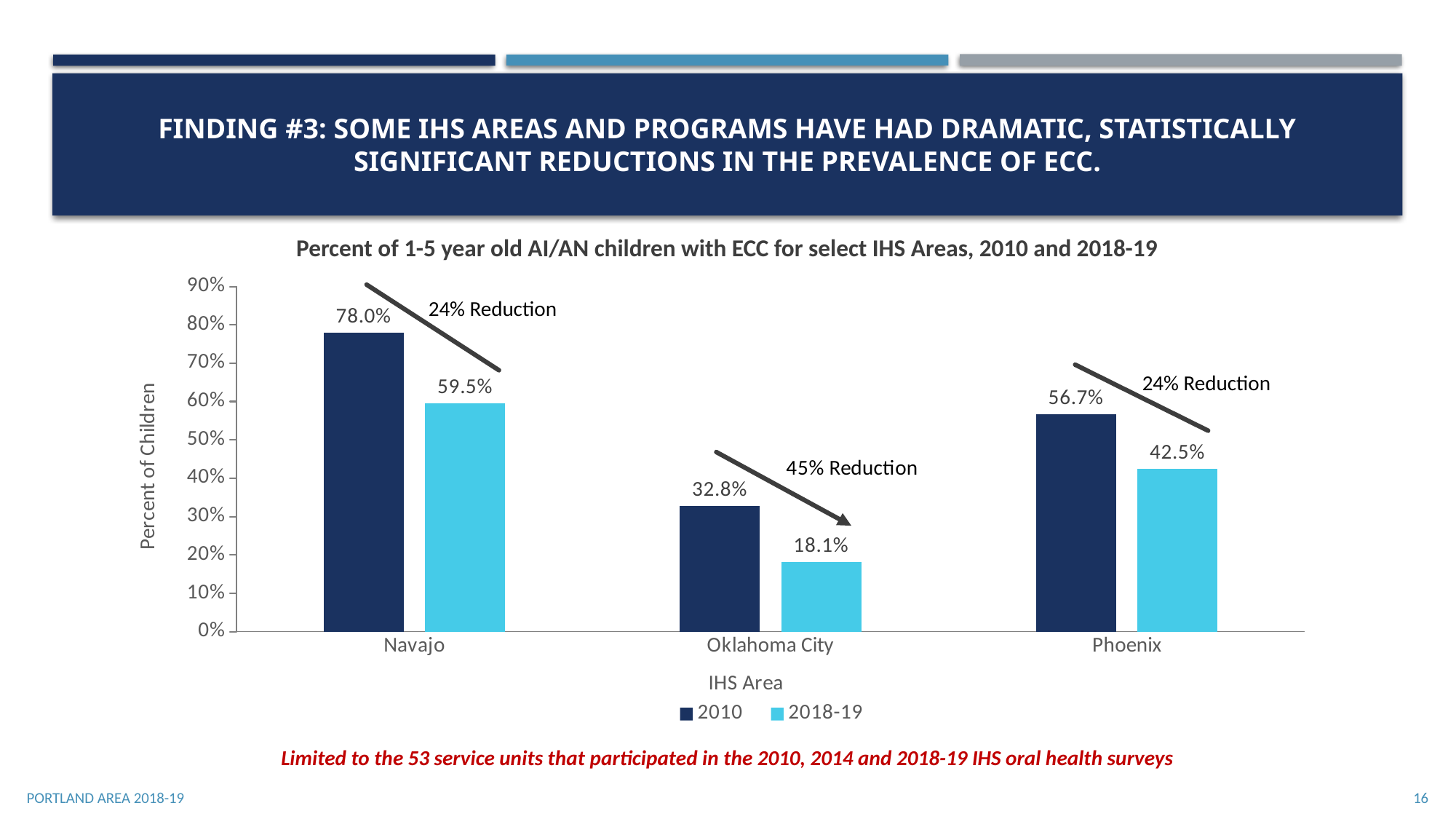
How many series does the legend list? 2 Which is larger: the 2018-19 value for Navajo or the 2010 value for Phoenix? 2018-19 value for Navajo Which IHS Area has the highest 2010 value? Navajo Which IHS Area has the lowest 2018-19 value? Oklahoma City What reduction is annotated for Oklahoma City? 45% Reduction What is the difference between the 2010 and 2018-19 values for Phoenix? 14.2% What is the difference between the 2010 and 2018-19 values for Navajo? 18.5% What is the 2018-19 value for Oklahoma City? 18.1% How many IHS Areas are shown on the x axis? 3 What is the 2018-19 value for Phoenix? 42.5% What kind of chart is shown on the slide? Bar chart What is the 2010 value for Navajo? 78.0%